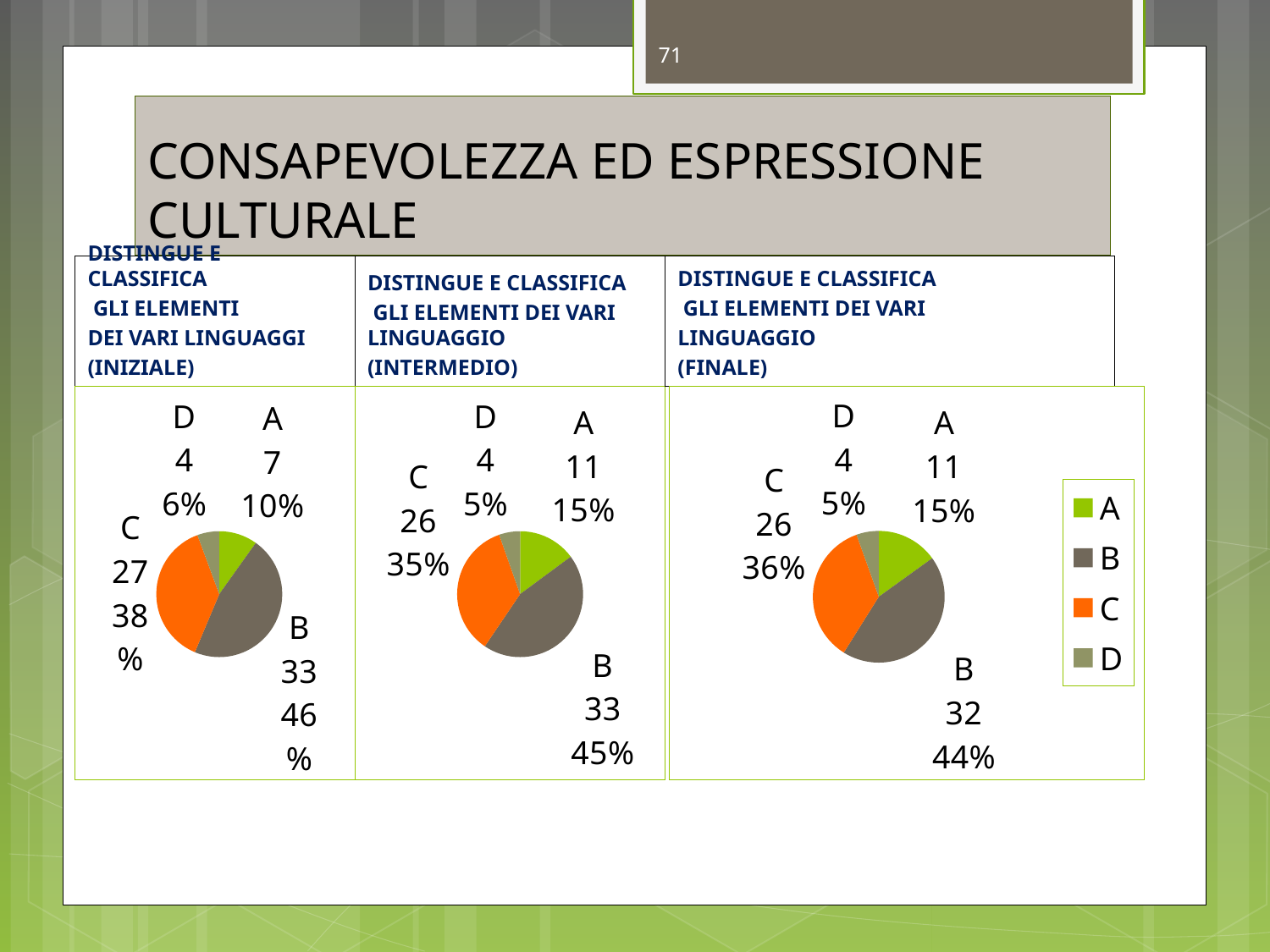
What type of chart is used on this slide? pie chart Which colour represents category C in the legend? orange In the left (INIZIALE) pie chart, what percentage share does category C have? 38% In the right (FINALE) pie chart, which category has the largest share? B In the right (FINALE) pie chart, what is the difference between the values for B and C? 6 In the right (FINALE) pie chart, what is the value for category C? 26 In the middle (INTERMEDIO) pie chart, what percentage share does category D have? 5% How many categories does each pie chart show? 4 In the left (INIZIALE) pie chart, which category has the smallest share? D In the left (INIZIALE) pie chart, what is the value for category B? 33 In the middle (INTERMEDIO) pie chart, which is larger, the value for A or the value for C? C In the middle (INTERMEDIO) pie chart, what is the value for category A? 11